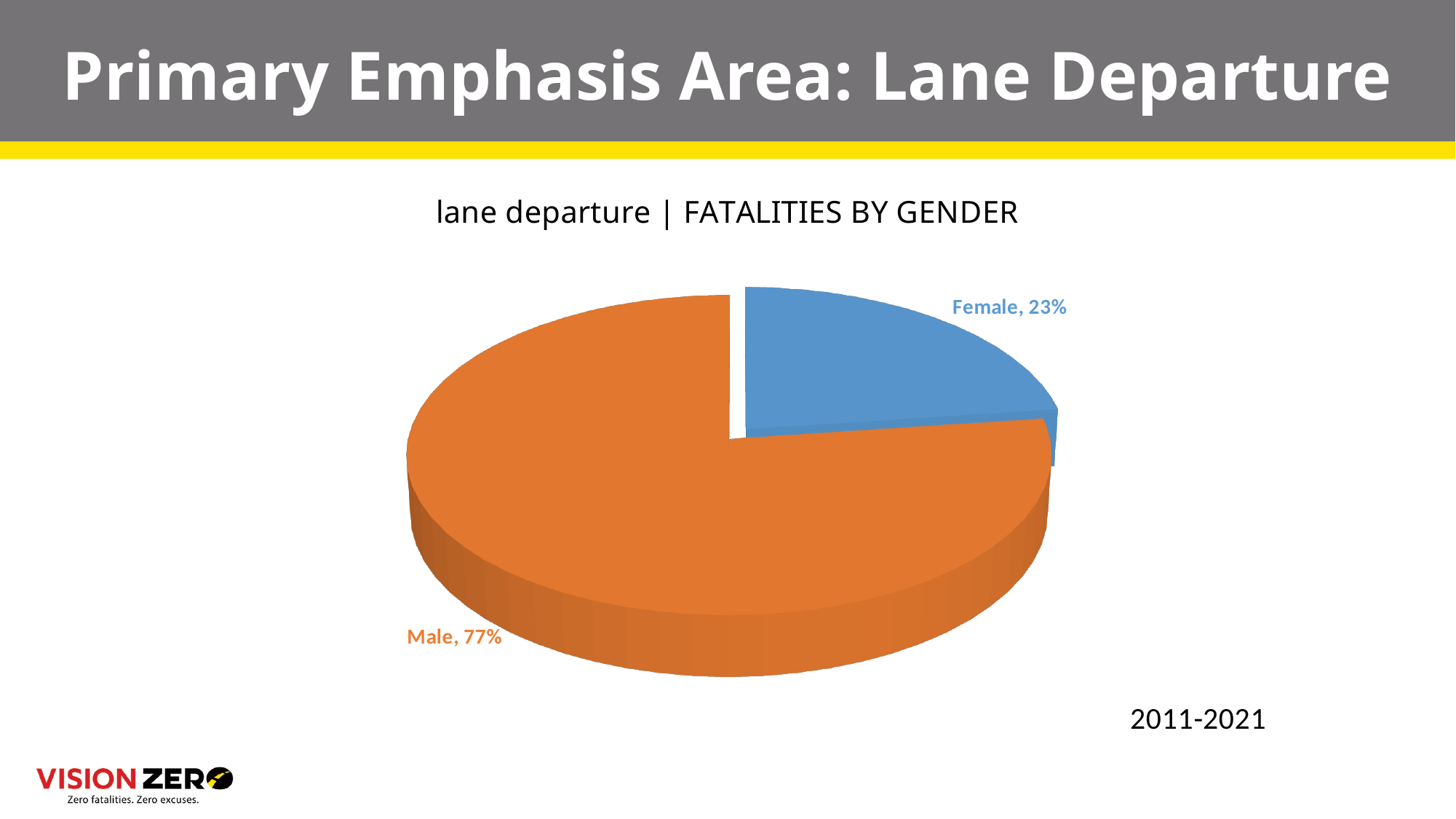
What kind of chart is shown on the slide? Pie chart Which gender accounts for the smallest share of lane departure fatalities? Female What is the difference in percentage points between the male and female shares of lane departure fatalities? 54 Which is larger, the male share or the female share of lane departure fatalities? Male What percentage of lane departure fatalities were female? 23% Which gender accounts for the largest share of lane departure fatalities? Male What share of the pie does the Female slice represent? 23% What colour is the Male slice of the pie chart? Orange How many slices does the pie chart have? 2 What is the title of the chart? lane departure | FATALITIES BY GENDER What percentage of lane departure fatalities were male? 77%